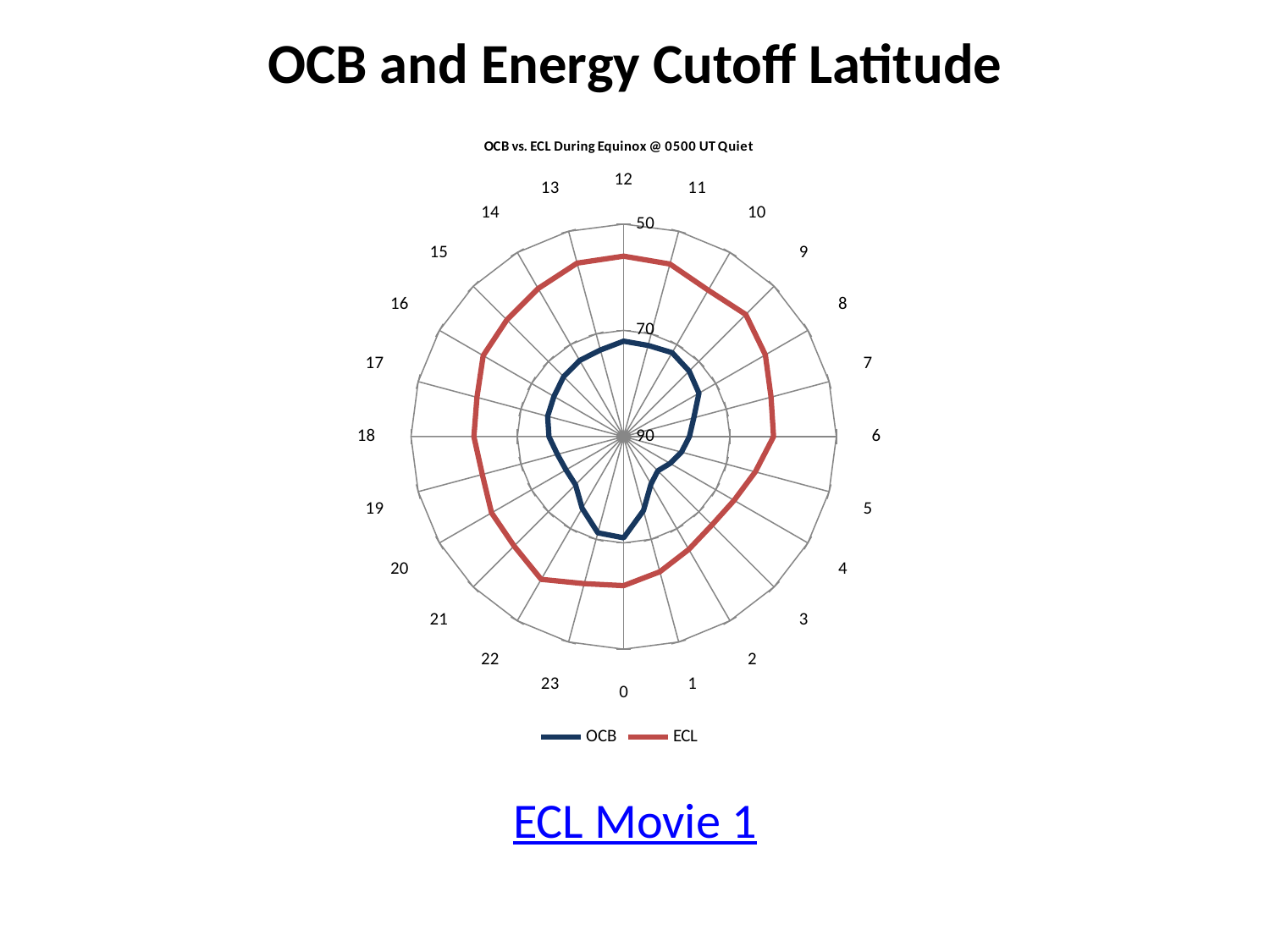
Is the OCB value at 6 greater or less than 70? greater Is the ECL value at 6 greater or less than 70? less How many categories (hour labels) are arranged around the chart? 24 Which series is drawn in red? ECL At hour 6, which series has the larger value, OCB or ECL? OCB What type of chart is shown on the slide? radar chart How many series does the legend list? 2 What is the title of the chart? OCB vs. ECL During Equinox @ 0500 UT Quiet Is the ECL value at 12 greater or less than 70? less